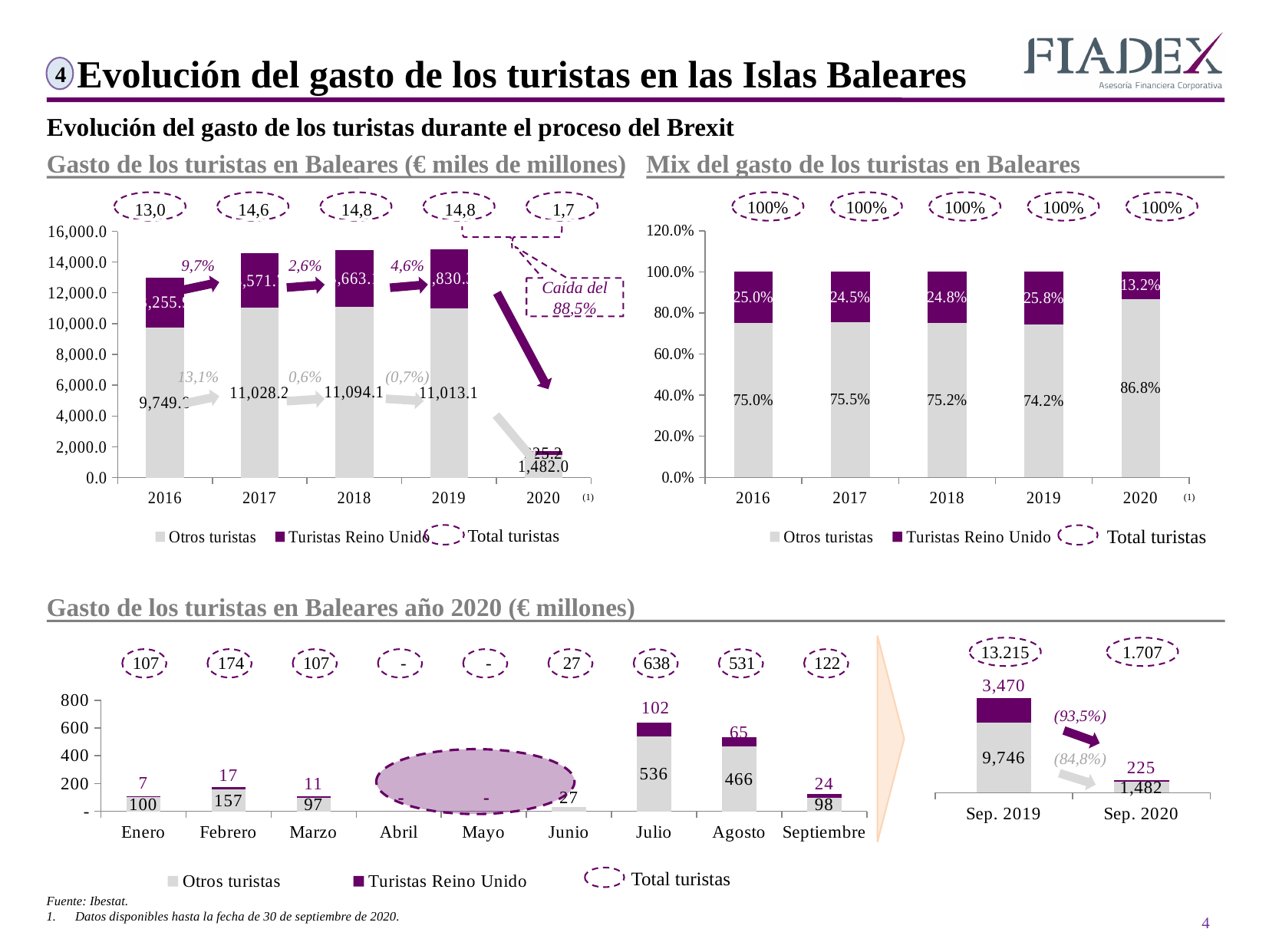
In the 'Mix del gasto de los turistas en Baleares' chart, what is the value for Turistas Reino Unido in 2019? 25.8% In the 'Gasto de los turistas en Baleares año 2020 (€ millones)' chart, which month has the highest total turistas value? Julio In the 'Gasto de los turistas en Baleares año 2020 (€ millones)' chart, how many months are shown on the x axis? 9 In the 'Gasto de los turistas en Baleares (€ miles de millones)' chart, what is the total turistas value shown for 2017? 14,6 In the 'Gasto de los turistas en Baleares (€ miles de millones)' chart, is the value for Otros turistas in 2020 greater or less than 2,000.0? less In the 'Mix del gasto de los turistas en Baleares' chart, which year has the lowest share for Turistas Reino Unido? 2020 What kind of chart is the 'Mix del gasto de los turistas en Baleares' chart? Stacked bar chart In the bottom-right chart comparing Sep. 2019 and Sep. 2020, what is the value for Turistas Reino Unido in Sep. 2019? 3,470 In the 'Mix del gasto de los turistas en Baleares' chart, what is the value for Otros turistas in 2020? 86.8% In the 'Gasto de los turistas en Baleares (€ miles de millones)' chart, what is the value for Otros turistas in 2018? 11,094.1 In the 'Gasto de los turistas en Baleares año 2020 (€ millones)' chart, what is the value for Otros turistas in Julio? 536 In the 'Gasto de los turistas en Baleares año 2020 (€ millones)' chart, what is the difference between the Turistas Reino Unido values for Julio and Agosto? 37